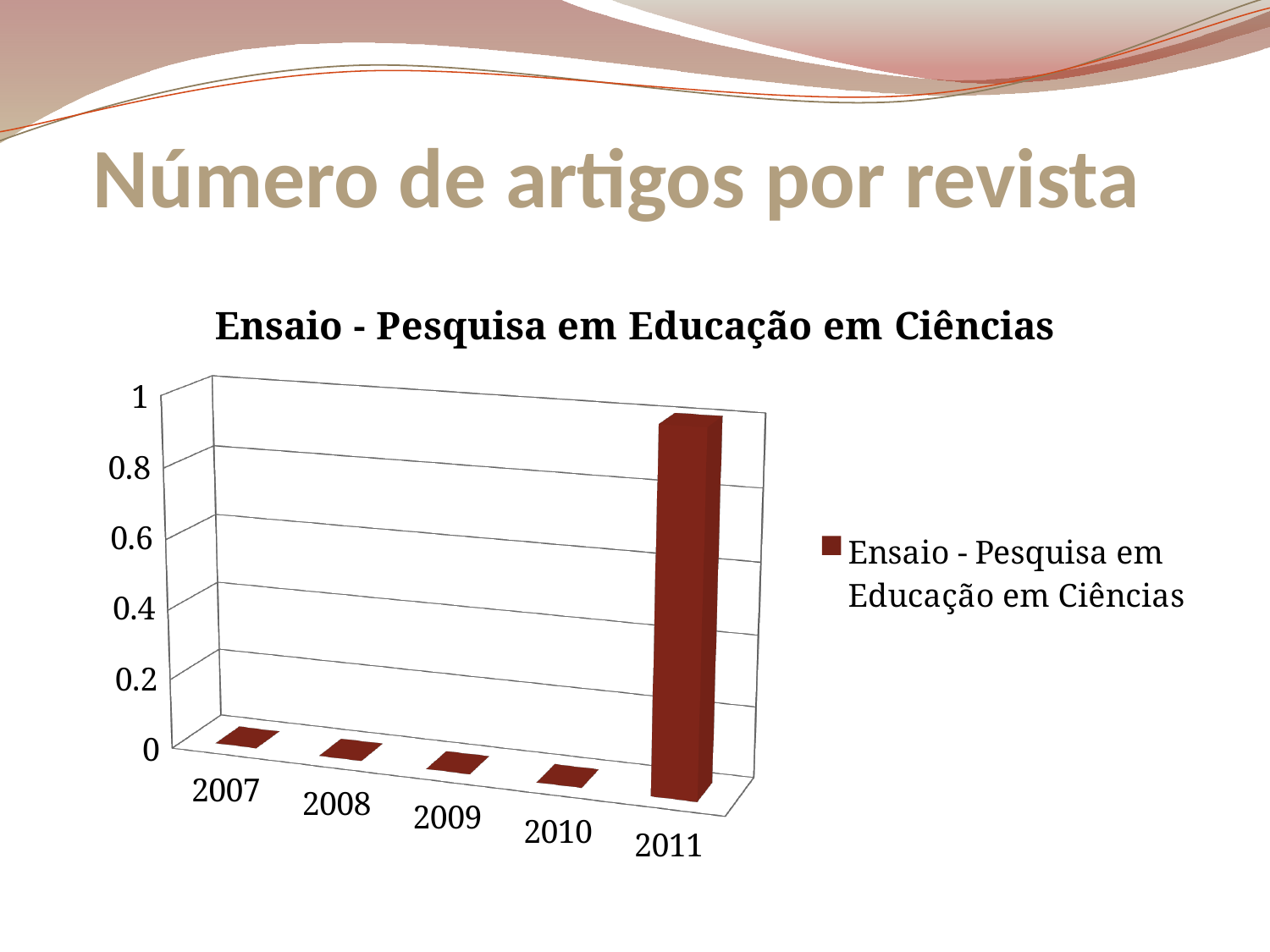
What kind of chart is shown on the slide? bar chart What is the value for 2011? 1 What is the value for 2009? 0 Is the value for 2010 greater or less than 0.2? less What is the value for 2007? 0 Which is larger, the value for 2008 or the value for 2011? 2011 Is the value for 2011 greater or less than 0.8? greater How many years are shown on the x axis of the chart? 5 Which year has the highest value in the chart? 2011 What is the title of the chart? Ensaio - Pesquisa em Educação em Ciências What is the difference between the values for 2011 and 2010? 1 How many series does the legend list? 1